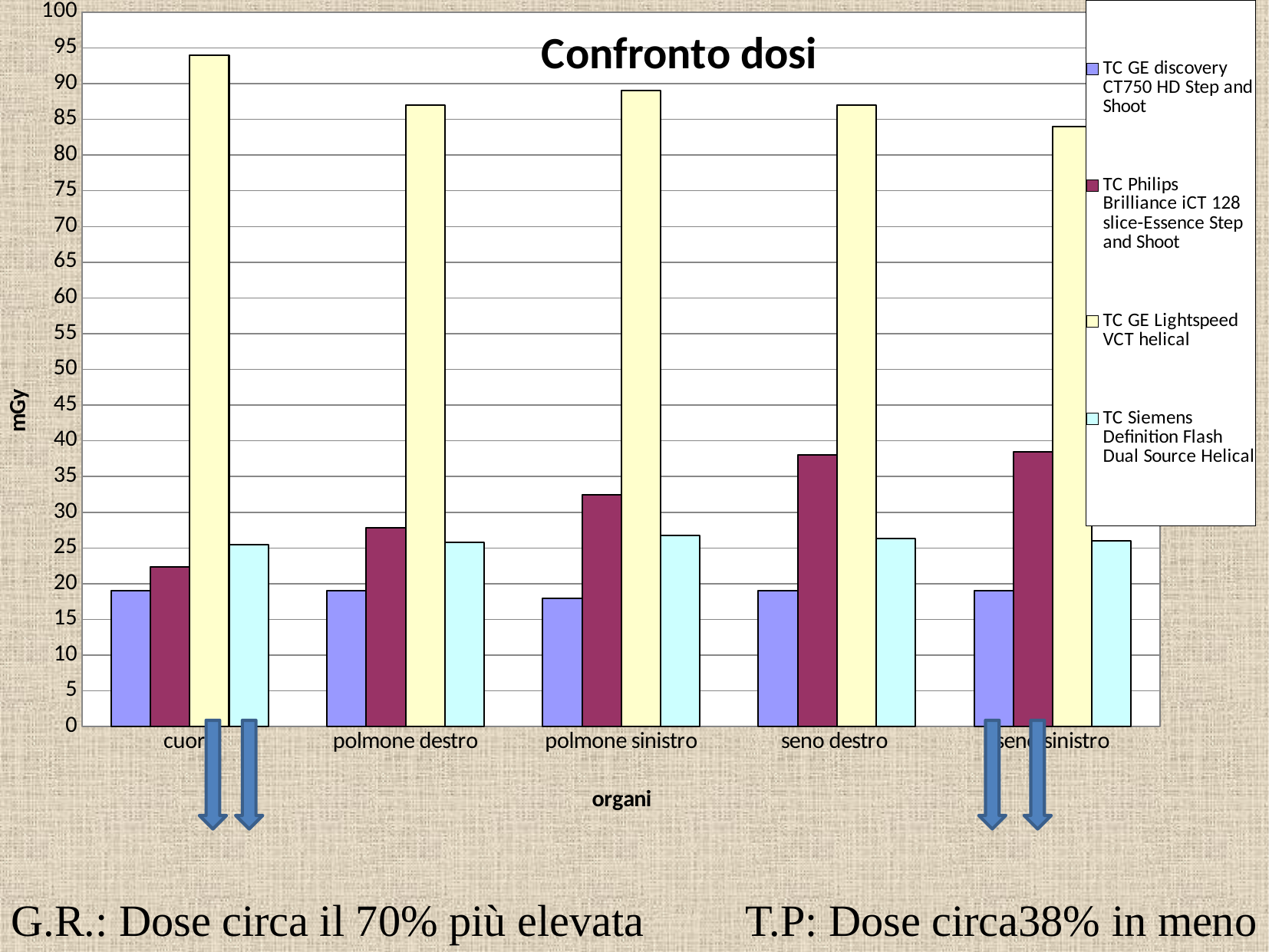
What kind of chart is shown on the slide? bar chart What is the title of the chart? Confronto dosi Is the TC GE Lightspeed VCT helical value for cuore greater or less than 90? greater Do the TC Philips Brilliance iCT 128 slice-Essence Step and Shoot values rise or fall from cuore to seno sinistro? rise How many organ categories are shown on the x axis? 5 What is the label of the y axis? mGy Is the TC Philips Brilliance iCT 128 slice-Essence Step and Shoot value for cuore greater or less than 25? less For which organ is the TC Philips Brilliance iCT 128 slice-Essence Step and Shoot value lowest? cuore For which organ is the TC GE Lightspeed VCT helical value highest? cuore Which series has the highest value for cuore? TC GE Lightspeed VCT helical How many series does the legend list? 4 For seno destro, which is larger: the TC Philips Brilliance iCT 128 slice-Essence Step and Shoot value or the TC Siemens Definition Flash Dual Source Helical value? TC Philips Brilliance iCT 128 slice-Essence Step and Shoot